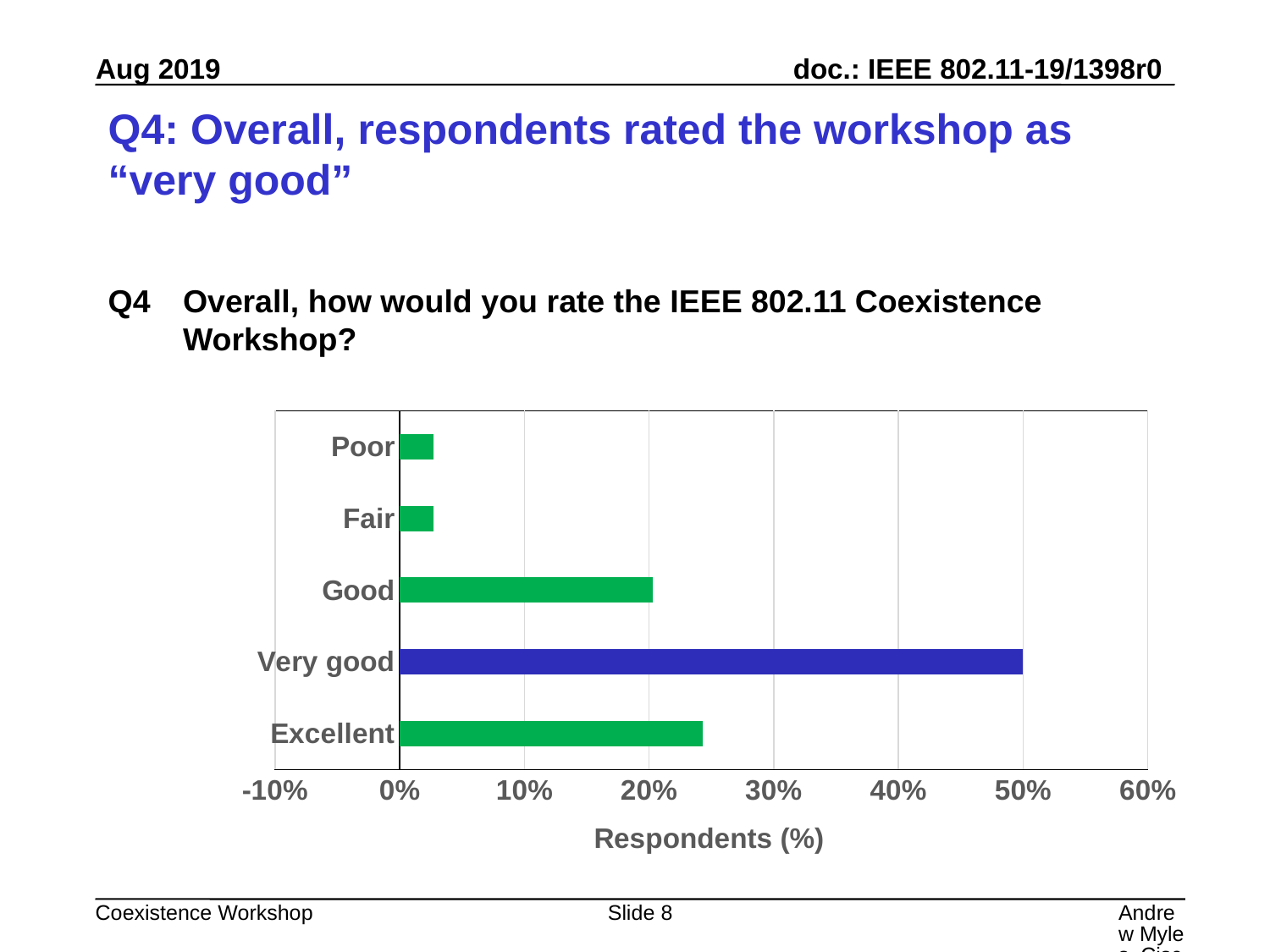
Is the value for Poor greater or less than 10%? less Which has a larger share of respondents, Good or Excellent? Excellent Which bar is coloured differently from the others? Very good Is the value for Excellent greater or less than 20%? greater Is the value for Fair greater or less than 10%? less Which has a larger share of respondents, Very good or Excellent? Very good What kind of chart is shown on the slide? bar chart How many rating categories are plotted on the chart? 5 Which rating category has the highest percentage of respondents? Very good What percentage of respondents rated the workshop as "Very good"? 50% What is the label of the horizontal axis? Respondents (%)